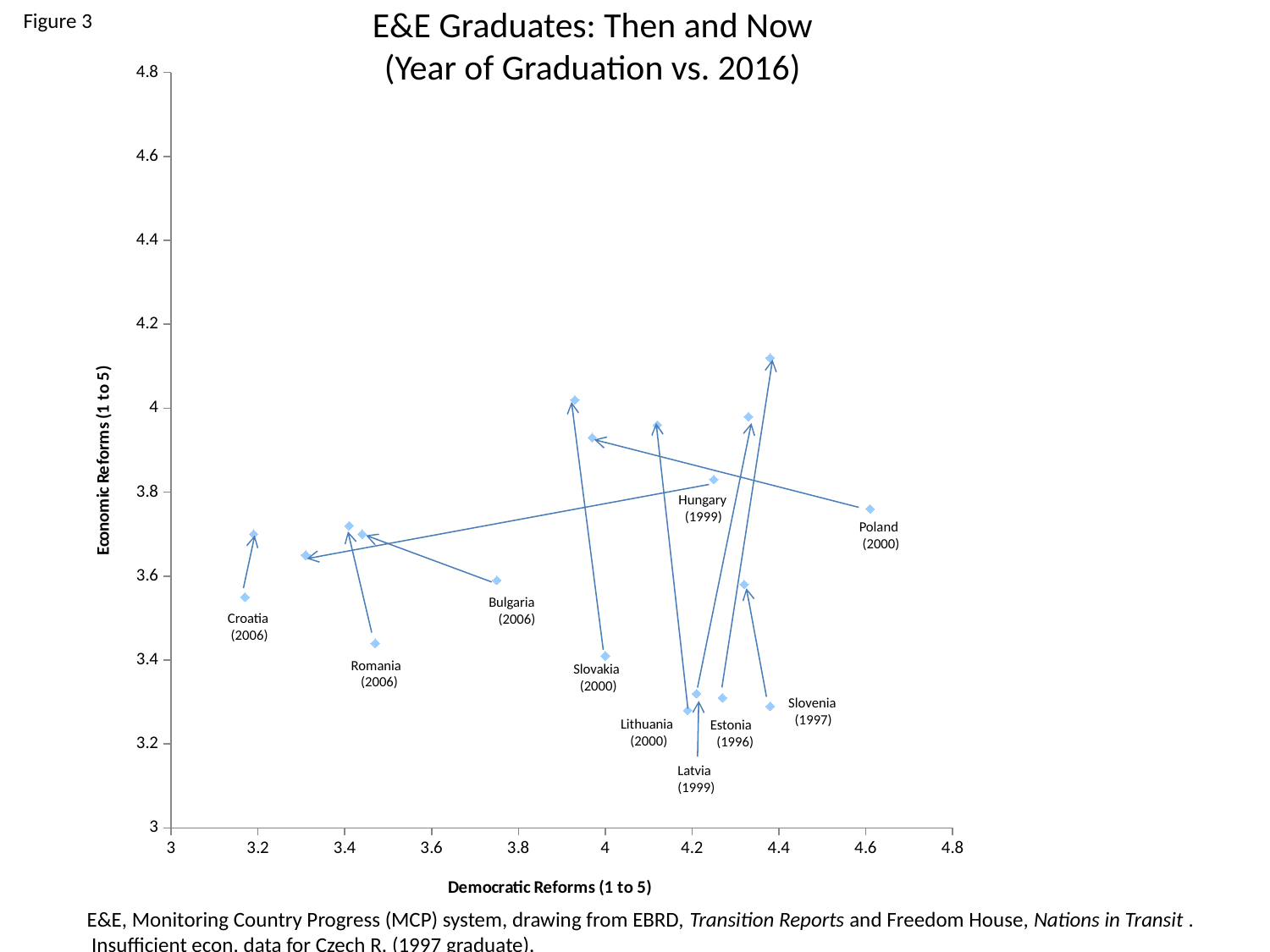
Which country's year-of-graduation point has the lowest Democratic Reforms score? Croatia What is the label of the x axis? Democratic Reforms (1 to 5) Is the Democratic Reforms score at Poland's year-of-graduation point greater or less than 4.4? greater Is the Economic Reforms score at Romania's year-of-graduation point greater or less than 3.6? less How many countries are labelled on the chart? 10 Is the Economic Reforms score at Slovenia's year-of-graduation point greater or less than 3.4? less What graduation year is shown for Estonia? 1996 What kind of chart is shown on the slide? scatter chart Which country's year-of-graduation point has the highest Democratic Reforms score? Poland What is the title of the chart? E&E Graduates: Then and Now (Year of Graduation vs. 2016) According to the arrow for Poland, did its Democratic Reforms score rise or fall between its graduation year and 2016? fall